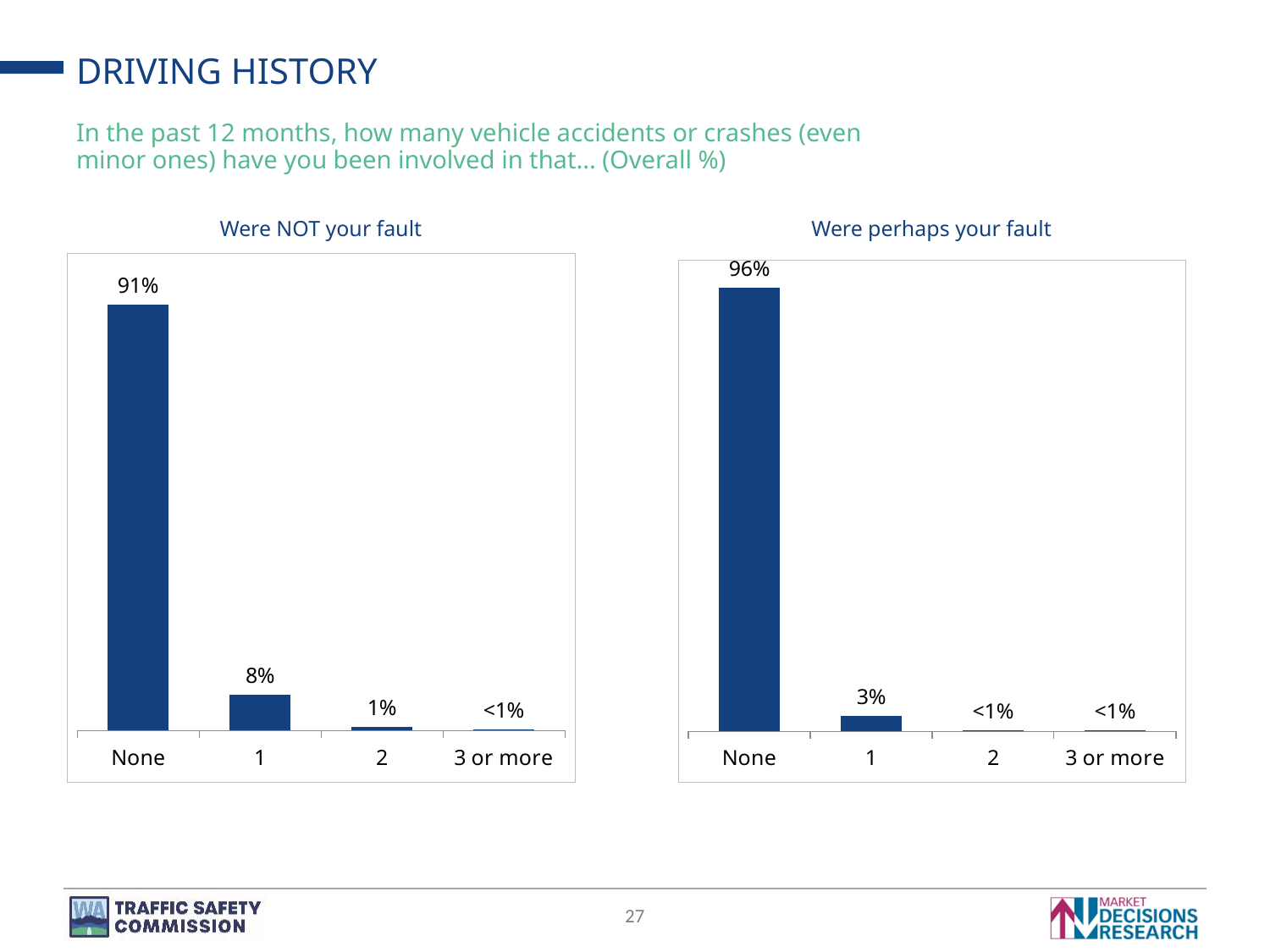
In the 'Were perhaps your fault' chart, which category has the highest value? None In the 'Were perhaps your fault' chart, what is the value for None? 96% In the 'Were perhaps your fault' chart, what is the value shown for 3 or more? <1% How many categories are shown on the x axis of the 'Were NOT your fault' chart? 4 Which is larger: the value for None in the 'Were NOT your fault' chart or the value for None in the 'Were perhaps your fault' chart? Were perhaps your fault What kind of chart is the 'Were perhaps your fault' chart? Bar chart In the 'Were NOT your fault' chart, what is the difference between the values for None and 1? 83% In the 'Were NOT your fault' chart, what is the value for None? 91% In the 'Were NOT your fault' chart, what is the value for 1? 8% In the 'Were NOT your fault' chart, what is the value for 2? 1% In the 'Were NOT your fault' chart, which category has the highest value? None In the 'Were perhaps your fault' chart, what is the value for 1? 3%